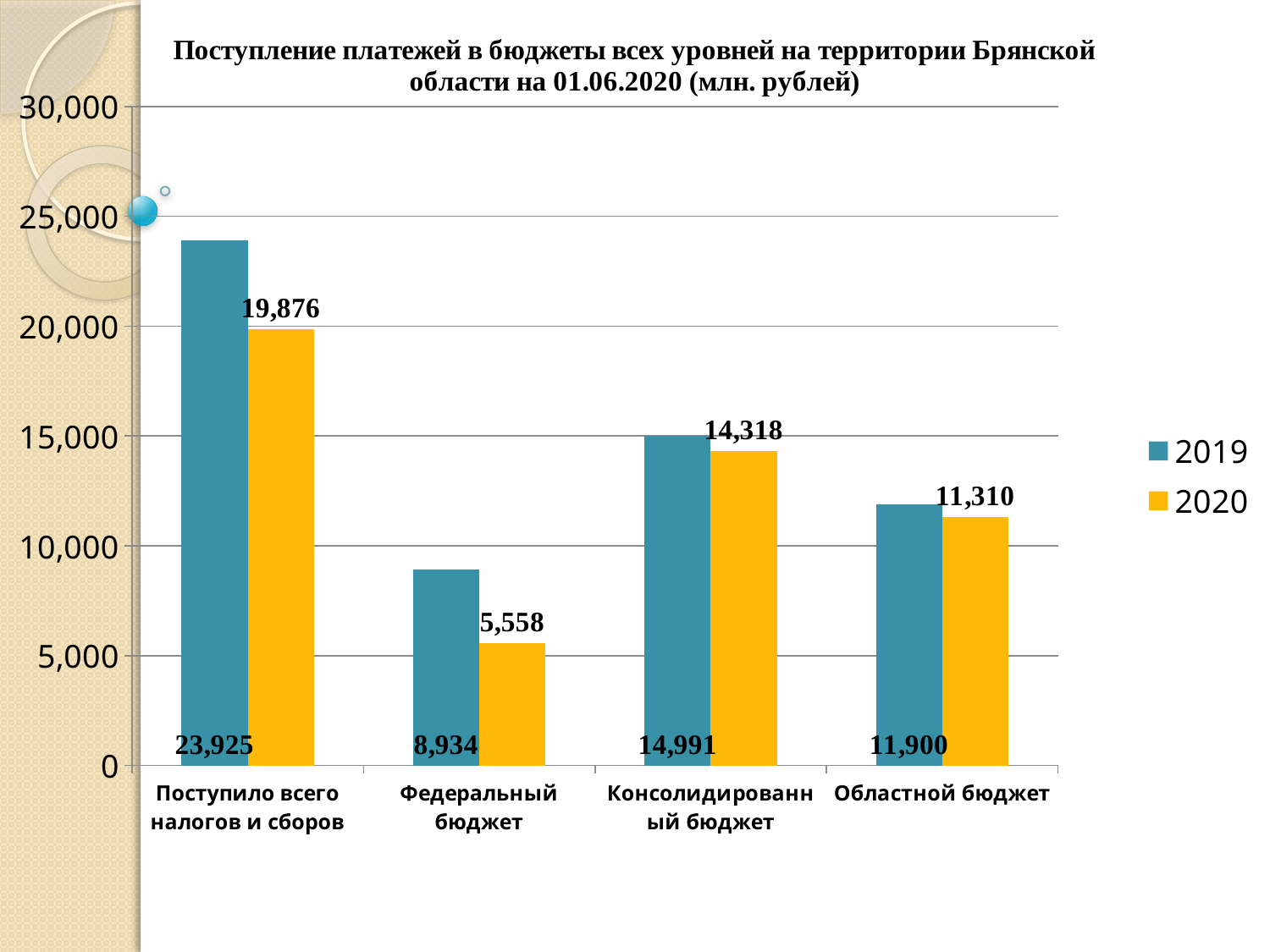
How many series does the legend list? 2 How many categories are shown on the x axis? 4 Which series is shown in yellow in the legend? 2020 What is the 2019 value for Областной бюджет? 11,900 What is the difference between the 2019 and 2020 values for Поступило всего налогов и сборов? 4,049 Which category has the lowest 2020 value? Федеральный бюджет What is the 2020 value for Консолидированный бюджет? 14,318 Which category has the highest 2019 value? Поступило всего налогов и сборов What kind of chart is shown on the slide? bar chart What is the 2019 value for Поступило всего налогов и сборов? 23,925 What is the 2020 value for Федеральный бюджет? 5,558 Which is larger for Федеральный бюджет, the 2019 value or the 2020 value? 2019